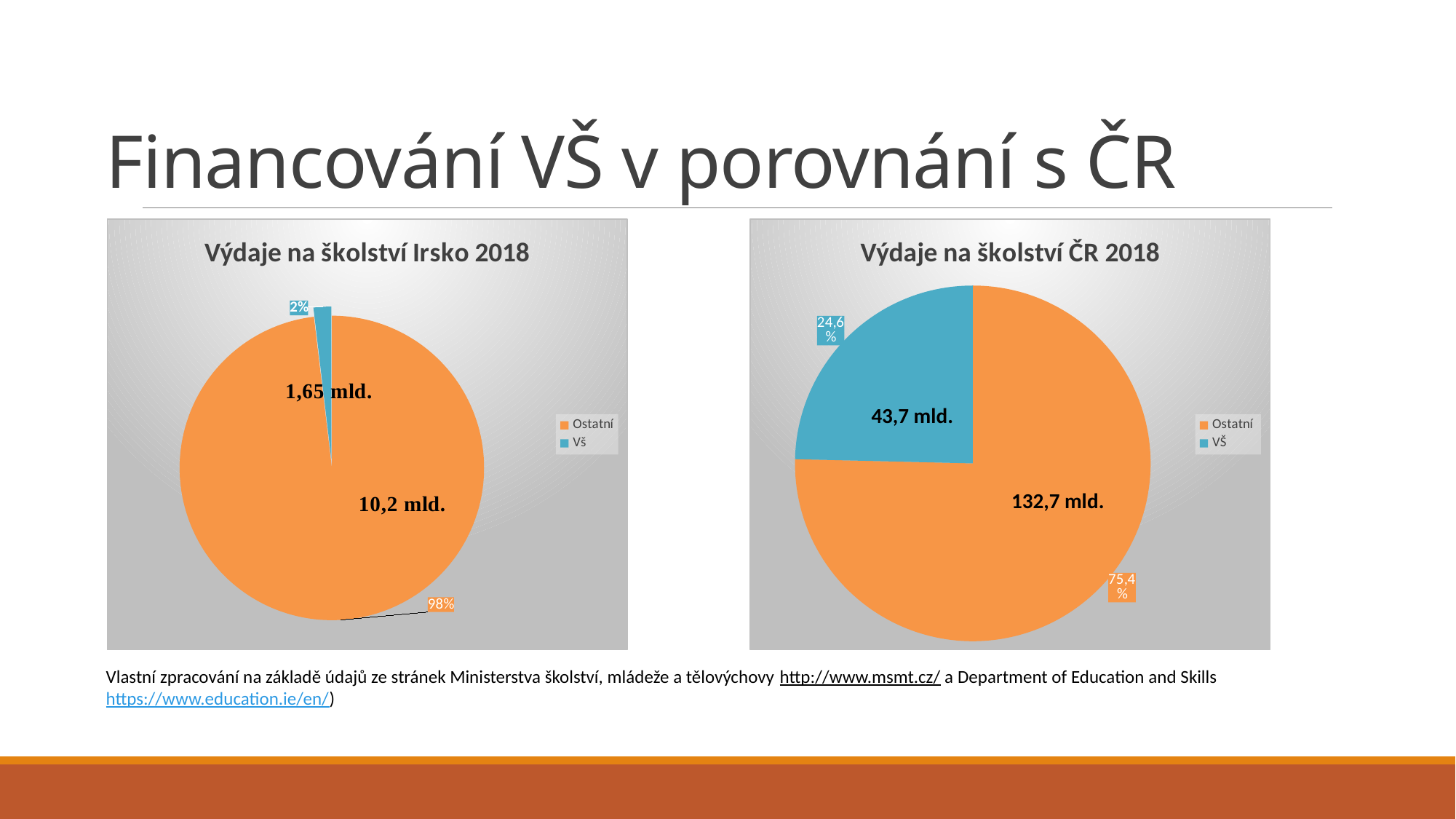
In the chart "Výdaje na školství ČR 2018", what amount is printed on the VŠ slice? 43,7 mld. In the chart "Výdaje na školství ČR 2018", what share of the pie is VŠ? 24,6 % How many entries does the legend of the chart "Výdaje na školství ČR 2018" list? 2 In the chart "Výdaje na školství Irsko 2018", which slice is the smallest? VŠ In the chart "Výdaje na školství Irsko 2018", what share of the pie is VŠ? 2% In the chart "Výdaje na školství ČR 2018", what amount is printed on the Ostatní slice? 132,7 mld. In the chart "Výdaje na školství ČR 2018", what share of the pie is Ostatní? 75,4 % In the chart "Výdaje na školství ČR 2018", what colour is the VŠ slice? blue In the chart "Výdaje na školství ČR 2018", which slice is the largest? Ostatní What kind of chart is "Výdaje na školství Irsko 2018"? pie chart In the chart "Výdaje na školství Irsko 2018", what amount is printed on the Ostatní slice? 10,2 mld.